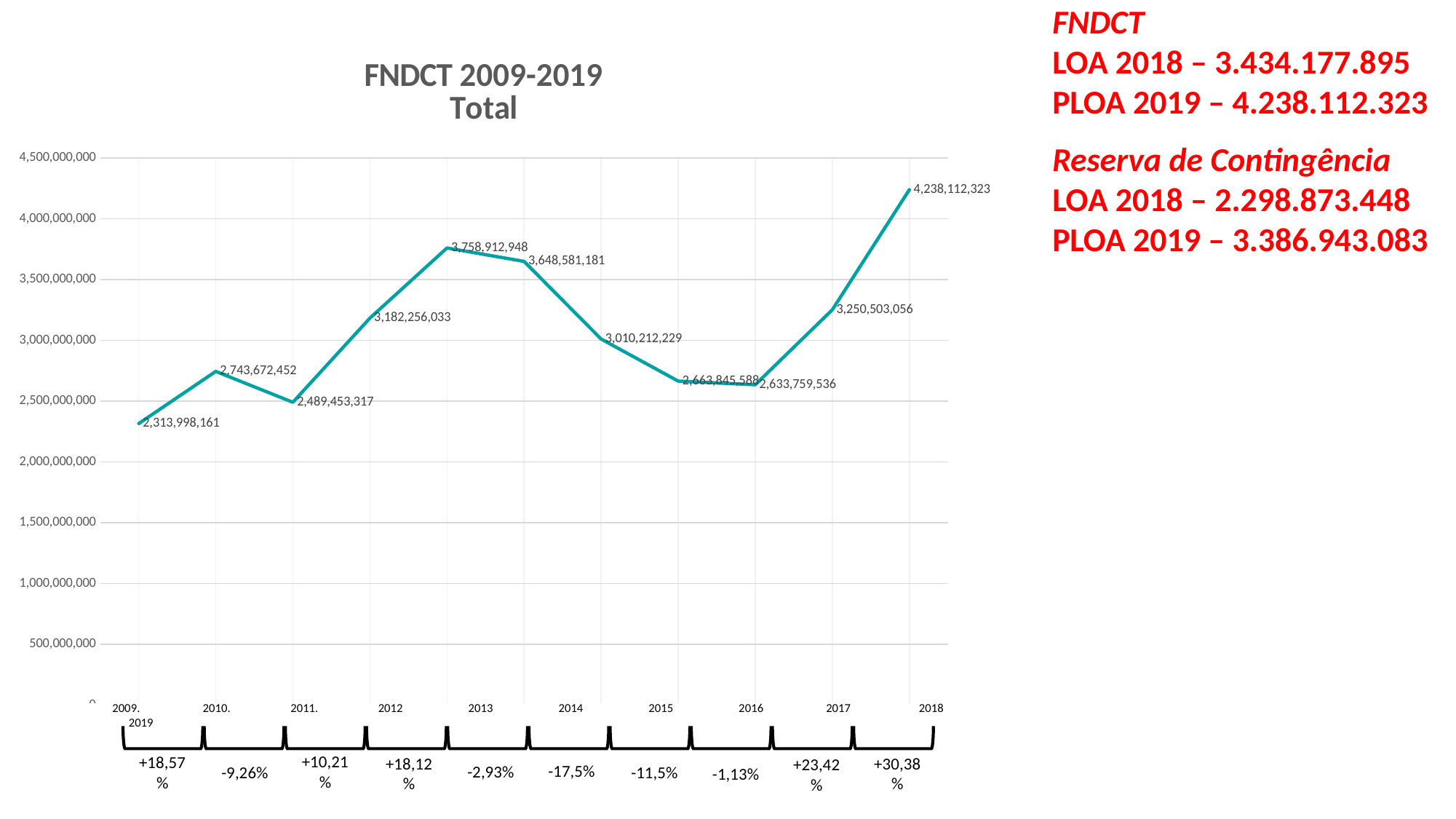
What is the difference between the highest and lowest plotted values? 1,924,114,162 What percentage change is shown in the first bracket below the chart (2009 to 2010)? +18,57% What kind of chart is shown on the slide? line chart What is the lowest value plotted on the chart? 2,313,998,161 How many data points are plotted on the line? 11 Does the line rise or fall between the second-to-last and the last plotted point? rise Which is larger, the value 3,758,912,948 or the value 3,648,581,181 that follows it? 3,758,912,948 What is the title of the chart? FNDCT 2009-2019 Total What is the highest value plotted on the chart? 4,238,112,323 Is the last plotted point greater or less than 4,000,000,000? greater What is the value of the first plotted point (2009)? 2,313,998,161 Is the value of the first plotted point (2009) greater or less than 2,500,000,000? less